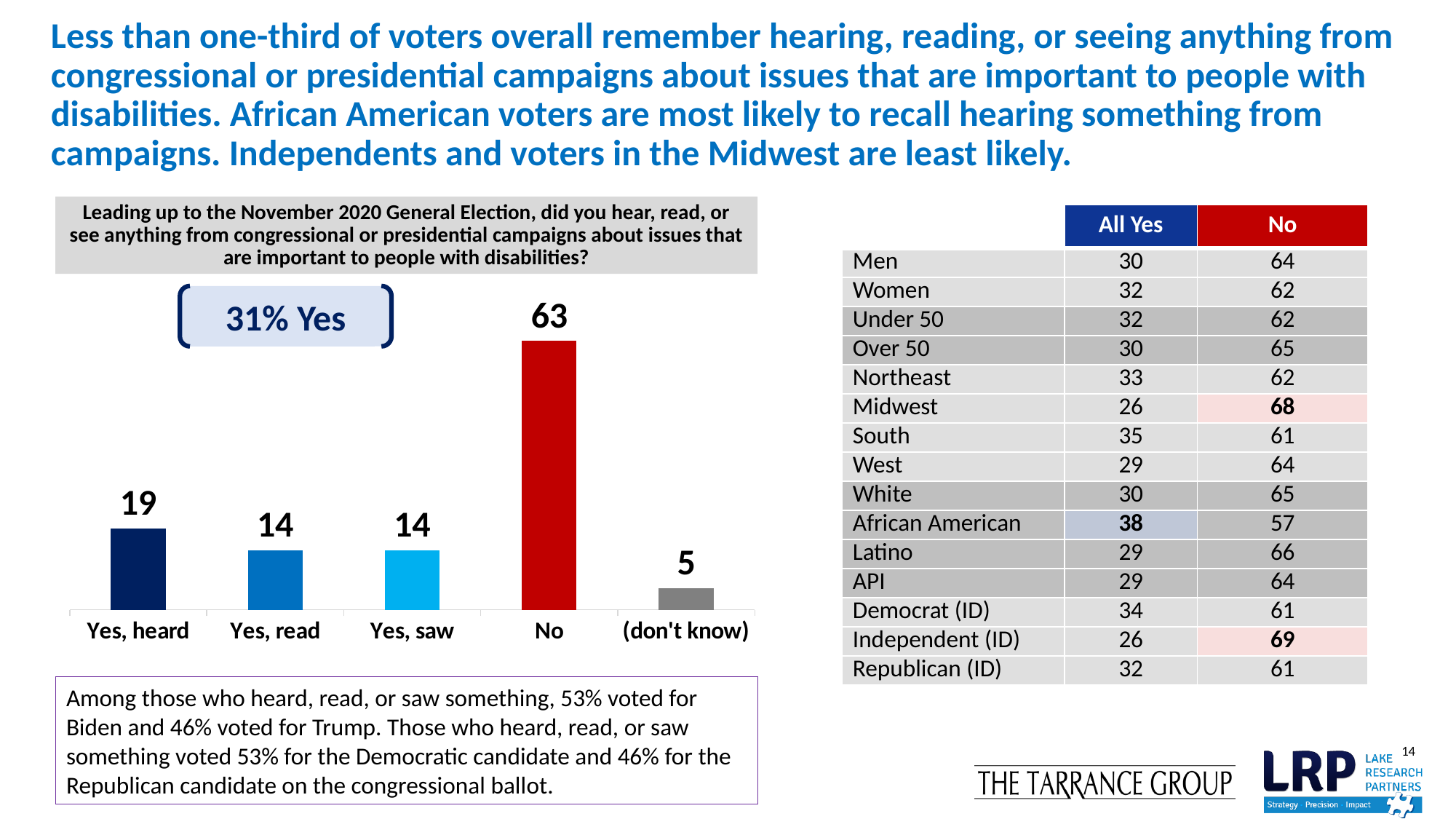
What is the value for the "No" bar in the chart? 63 How many categories are shown on the x axis of the chart? 5 What is the value for "(don't know)" in the chart? 5 Which category has the highest value in the chart? No Which is larger, the value for "Yes, heard" or the value for "Yes, saw"? Yes, heard What is the difference between the "No" bar and the "Yes, heard" bar? 44 What overall "Yes" percentage is shown in the callout box on the chart? 31% Yes What type of chart is shown on the slide? Bar chart What is the value for "Yes, heard" in the chart? 19 Which category has the lowest value in the chart? (don't know) What is the value for "Yes, read" in the chart? 14 What colour is the "No" bar in the chart? Red